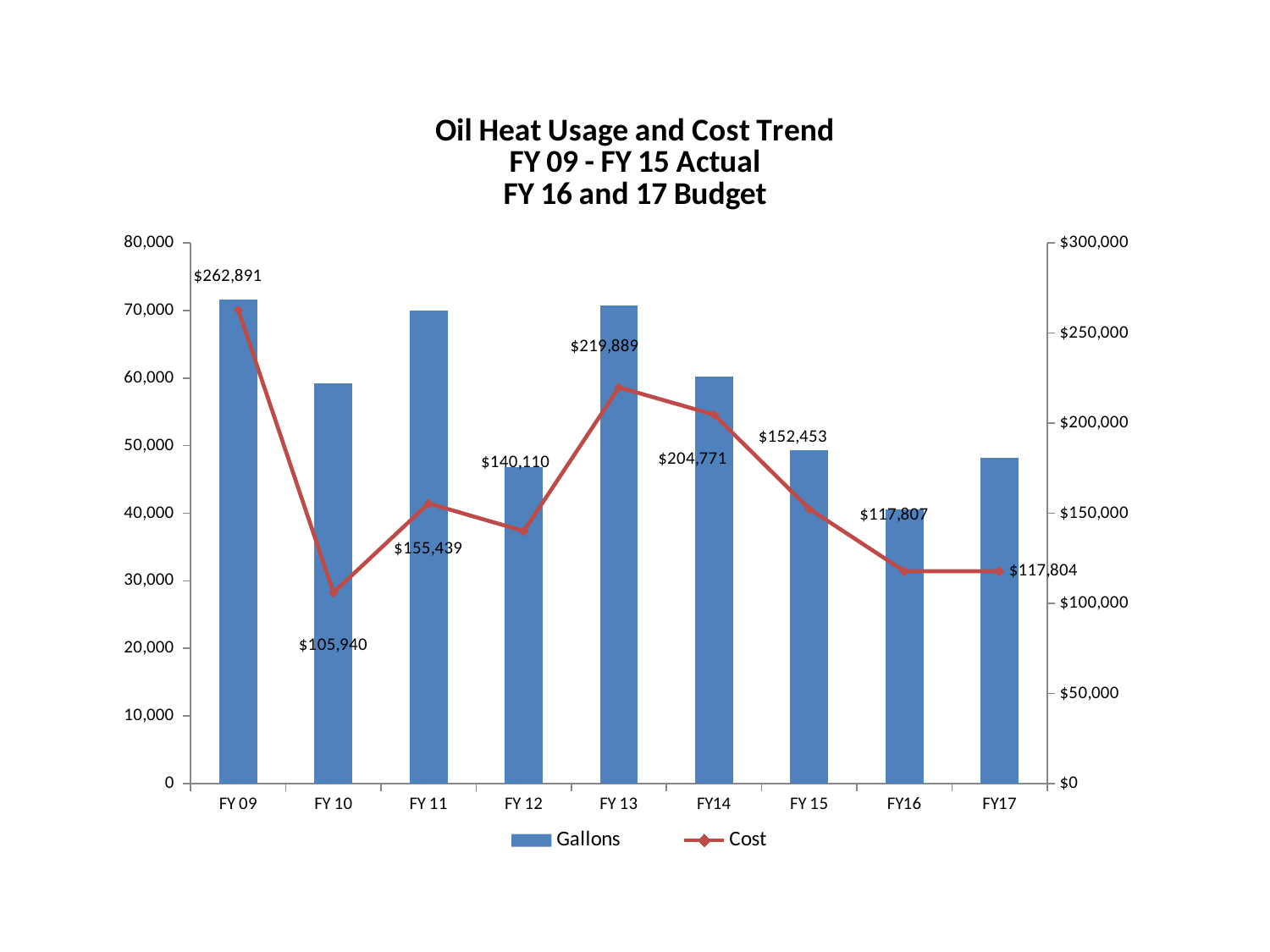
How many series does the legend list? 2 Is the Gallons value for FY16 greater or less than 50,000? less What is the difference in Cost between FY 09 and FY 10? $156,951 Which fiscal year has the highest Cost? FY 09 Which fiscal year has the lowest Cost? FY 10 Which has the higher Cost, FY 13 or FY14? FY 13 How many fiscal years are shown on the x axis? 9 Is the Gallons value for FY 09 greater or less than 60,000? greater What is the Cost value for FY 09? $262,891 What is the Cost value for FY 13? $219,889 What is the Cost value for FY17? $117,804 Does the Cost rise or fall from FY 13 to FY16? fall